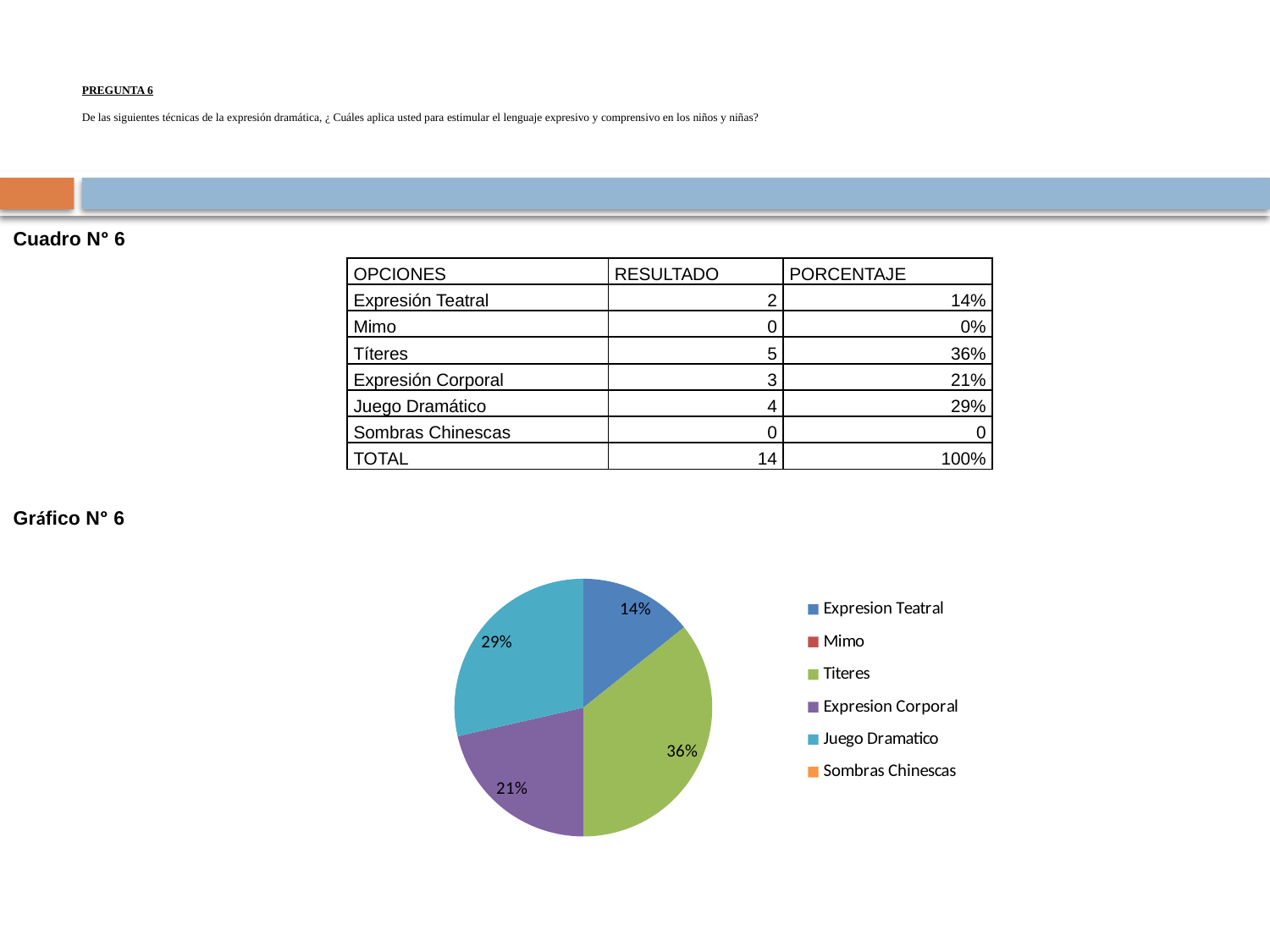
In the pie chart, what percentage is shown for Juego Dramatico? 29% In the pie chart, what percentage is shown for Expresion Corporal? 21% How many slices with a printed percentage label are visible in the pie chart? 4 In the pie chart, what is the difference in percentage points between Titeres and Expresion Teatral? 22 Among the slices with a printed label, which category has the smallest share in the pie chart? Expresion Teatral In the pie chart, which is larger: the slice for Juego Dramatico or the slice for Expresion Corporal? Juego Dramatico Which category has the largest slice in the pie chart? Titeres What colour is the slice for Titeres in the pie chart? green How many entries does the legend of the pie chart list? 6 In the pie chart, what percentage is shown for Expresion Teatral? 14% In the pie chart, what percentage is shown for Titeres? 36% What kind of chart is shown under "Gráfico N° 6"? pie chart